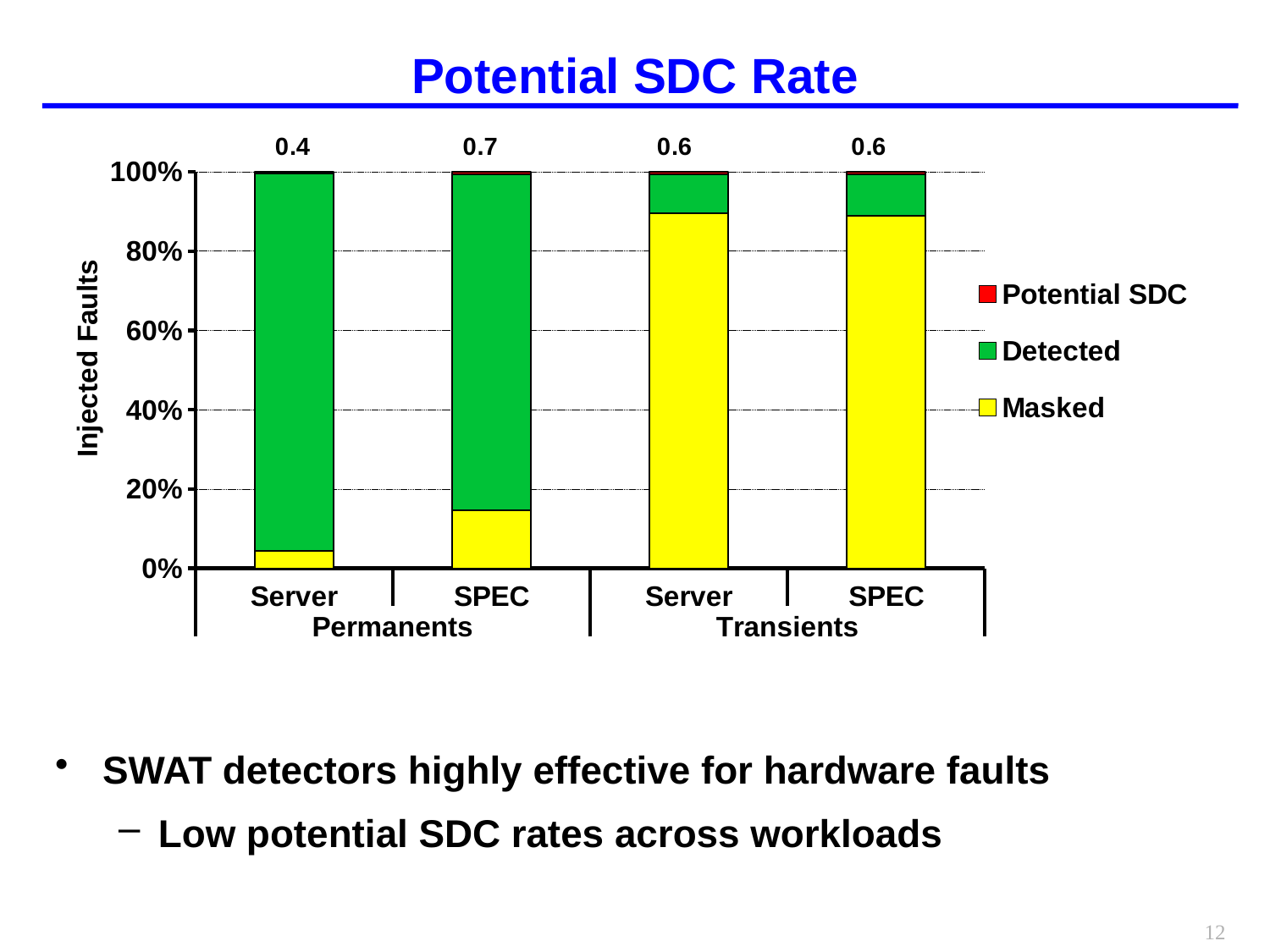
What is the title of the chart? Potential SDC Rate How many series does the legend list? 3 What value is printed above the Server bar under Transients? 0.6 What kind of chart is shown on the slide? stacked bar chart Is the Masked share for the Server bar under Permanents greater or less than 20%? less How many bars are plotted in the chart? 4 Which bar has the lowest value printed above it? Server (Permanents) What value is printed above the Server bar under Permanents? 0.4 What is the difference between the values printed above the SPEC and Server bars under Permanents? 0.3 Is the Masked share for the Server bar under Transients greater or less than 80%? greater Which bar has the highest value printed above it? SPEC (Permanents) What value is printed above the SPEC bar under Permanents? 0.7